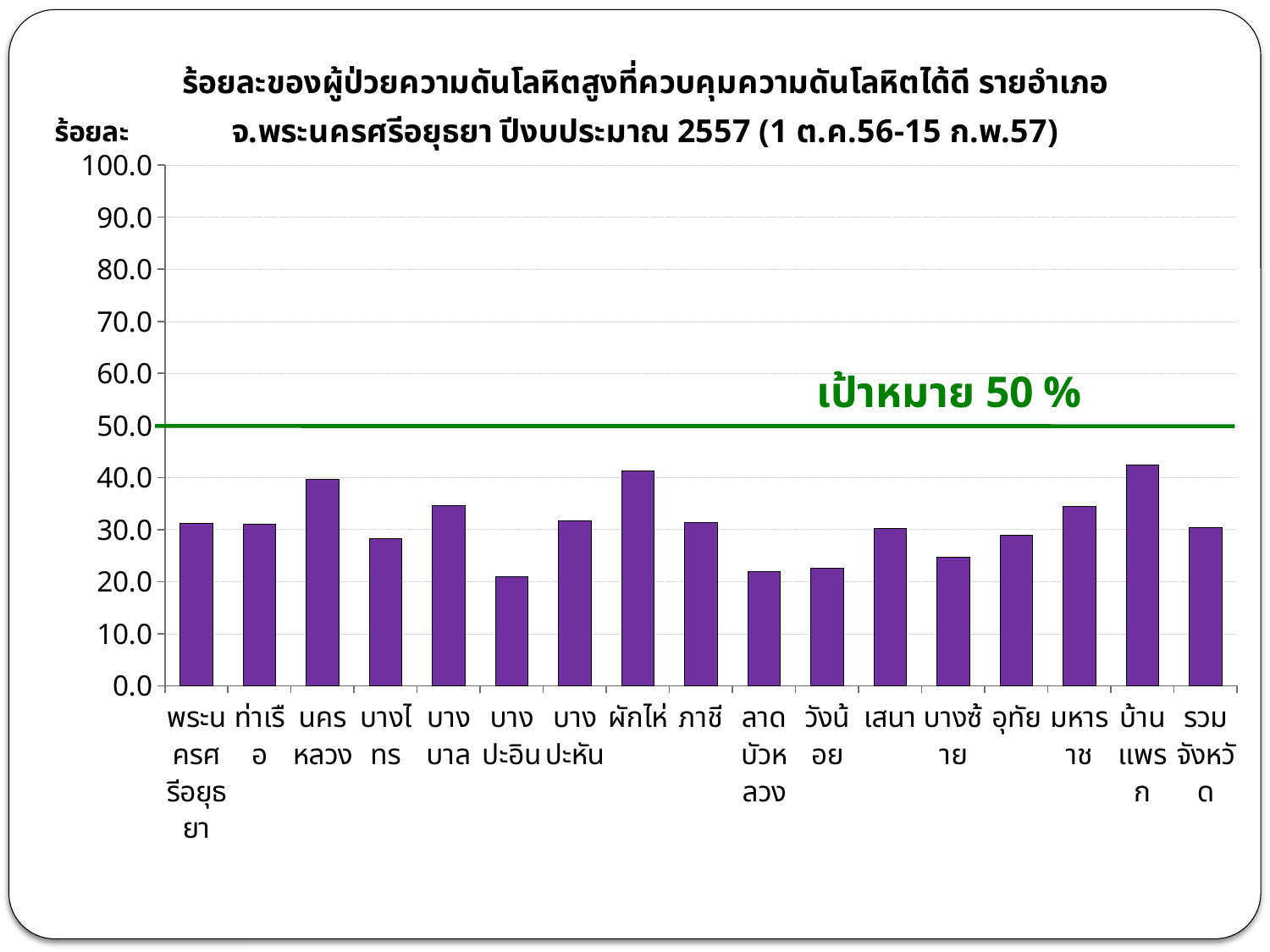
What target value is marked by the green horizontal line on the chart? 50 % How many categories (bars) are plotted on the chart? 17 Is the value for บ้านแพรก greater or less than 40? greater What label is shown on the vertical axis of the chart? ร้อยละ Is the value for บางปะอิน greater or less than 30? less Is the value for ผักไห่ greater or less than 30? greater Which is larger, the value for นครหลวง or the value for บางไทร? นครหลวง Which is larger, the value for บางบาล or the value for บางปะอิน? บางบาล Which category has the highest value on the chart? บ้านแพรก How many bars reach or exceed the green target line at 50? 0 What kind of chart is shown on the slide? bar chart